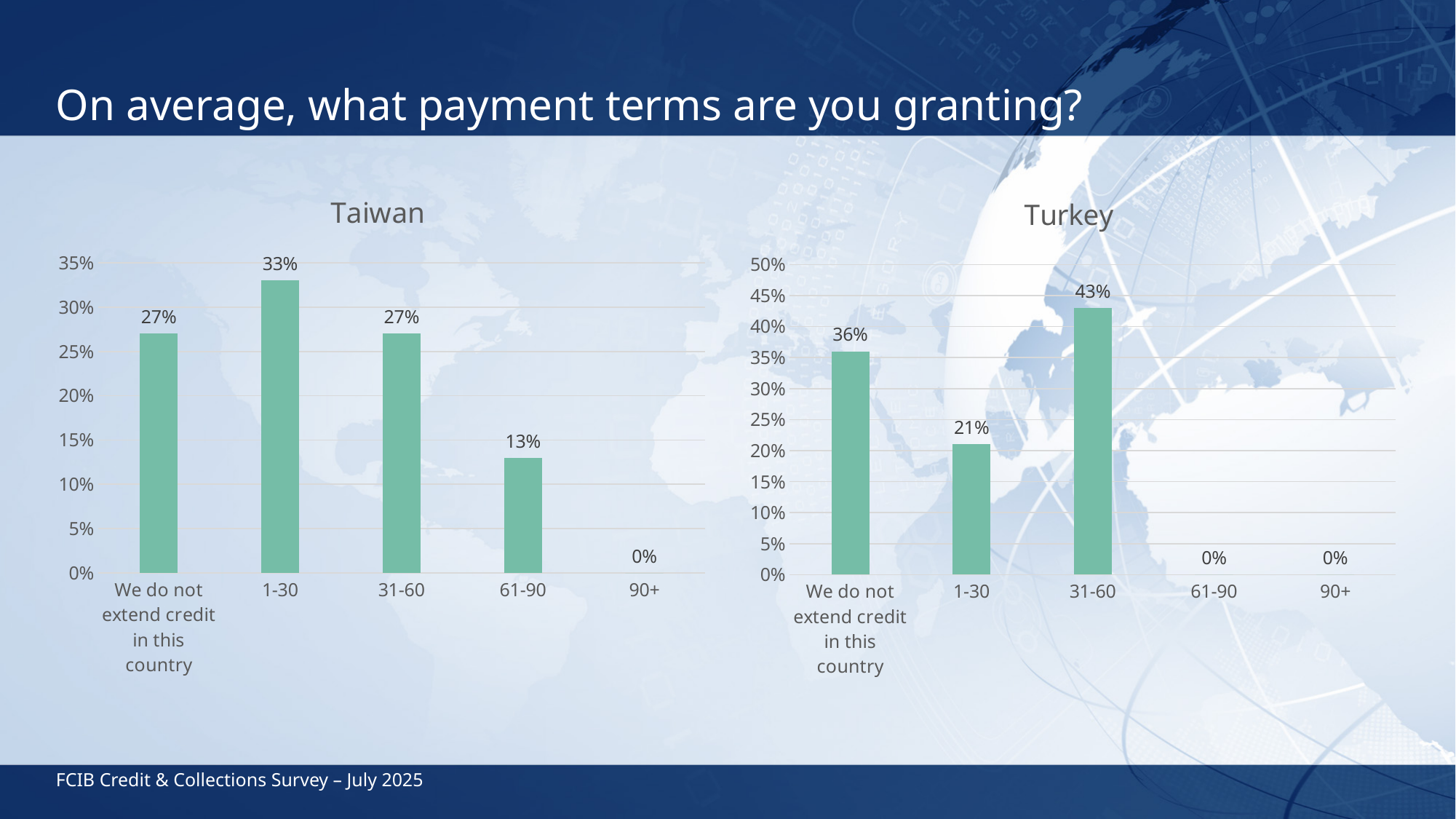
In the Taiwan chart, what is the difference between the values for 1-30 and 61-90? 20% In the Turkey chart, how many categories have a value of 0%? 2 In the Turkey chart, what is the value for 'We do not extend credit in this country'? 36% How many categories are shown on the x axis of the Taiwan chart? 5 In the Turkey chart, which is larger, the value for 'We do not extend credit in this country' or the value for 1-30? We do not extend credit in this country In the Taiwan chart, what is the value for 61-90? 13% In the Turkey chart, what is the difference between the values for 31-60 and 1-30? 22% In the Taiwan chart, which category has the highest value? 1-30 In the Taiwan chart, what is the value for 1-30? 33% In the Turkey chart, what is the value for 31-60? 43% In the Turkey chart, which category has the highest value? 31-60 What kind of chart is the Turkey chart? Bar chart